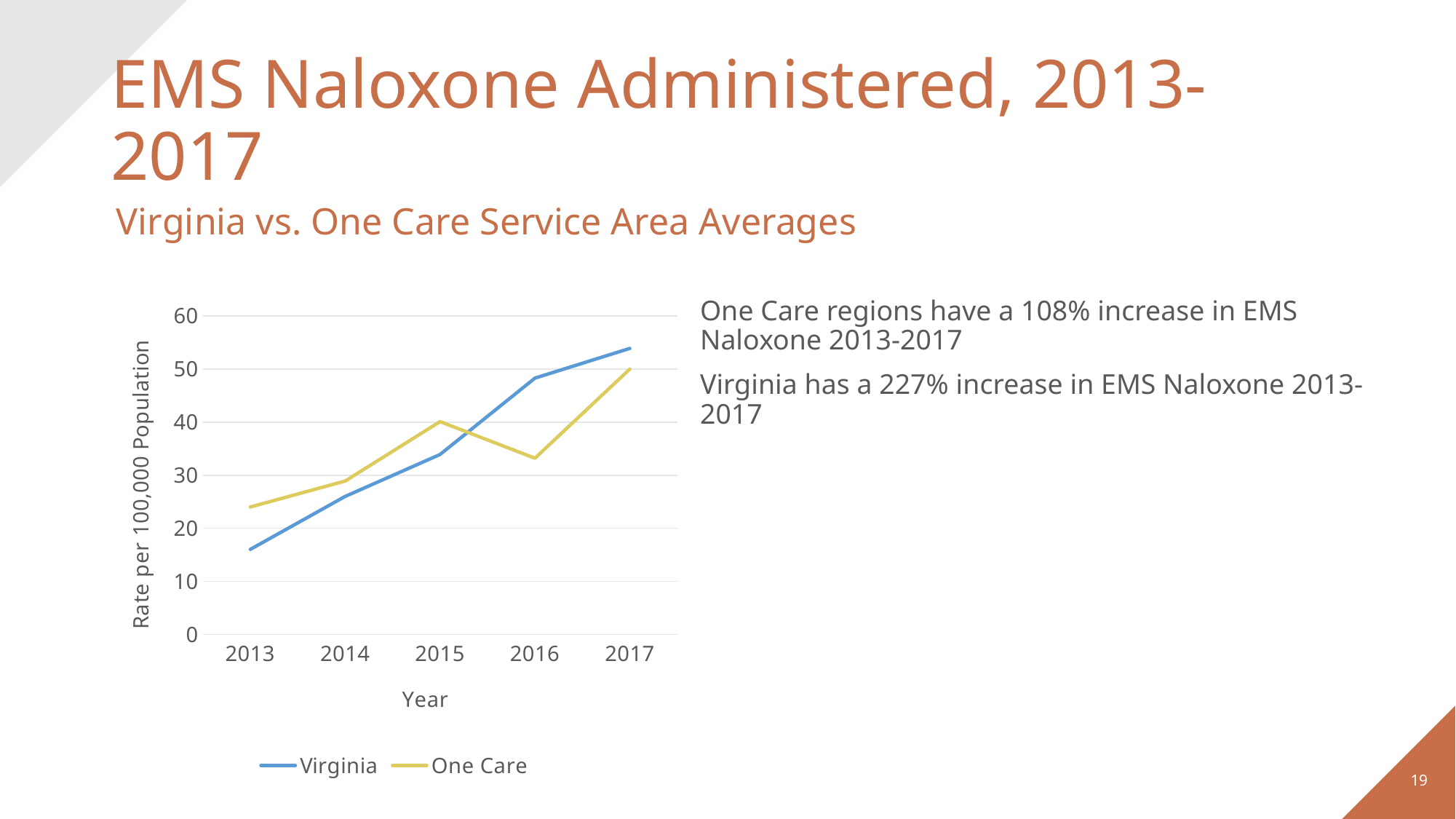
In 2016, which series has the higher value, Virginia or One Care? Virginia What is the label of the y axis? Rate per 100,000 Population What kind of chart is shown on the slide? Line chart Is the value for Virginia in 2013 greater or less than 20? less In which year is the Virginia value highest? 2017 Is the value for Virginia in 2017 greater or less than 50? greater How many years are plotted on the x axis? 5 In which year is the One Care value lowest? 2013 How many series does the legend list? 2 Is the value for One Care in 2016 greater or less than 40? less In 2013, which series has the higher value, Virginia or One Care? One Care Does the Virginia line rise or fall from 2013 to 2017? Rises